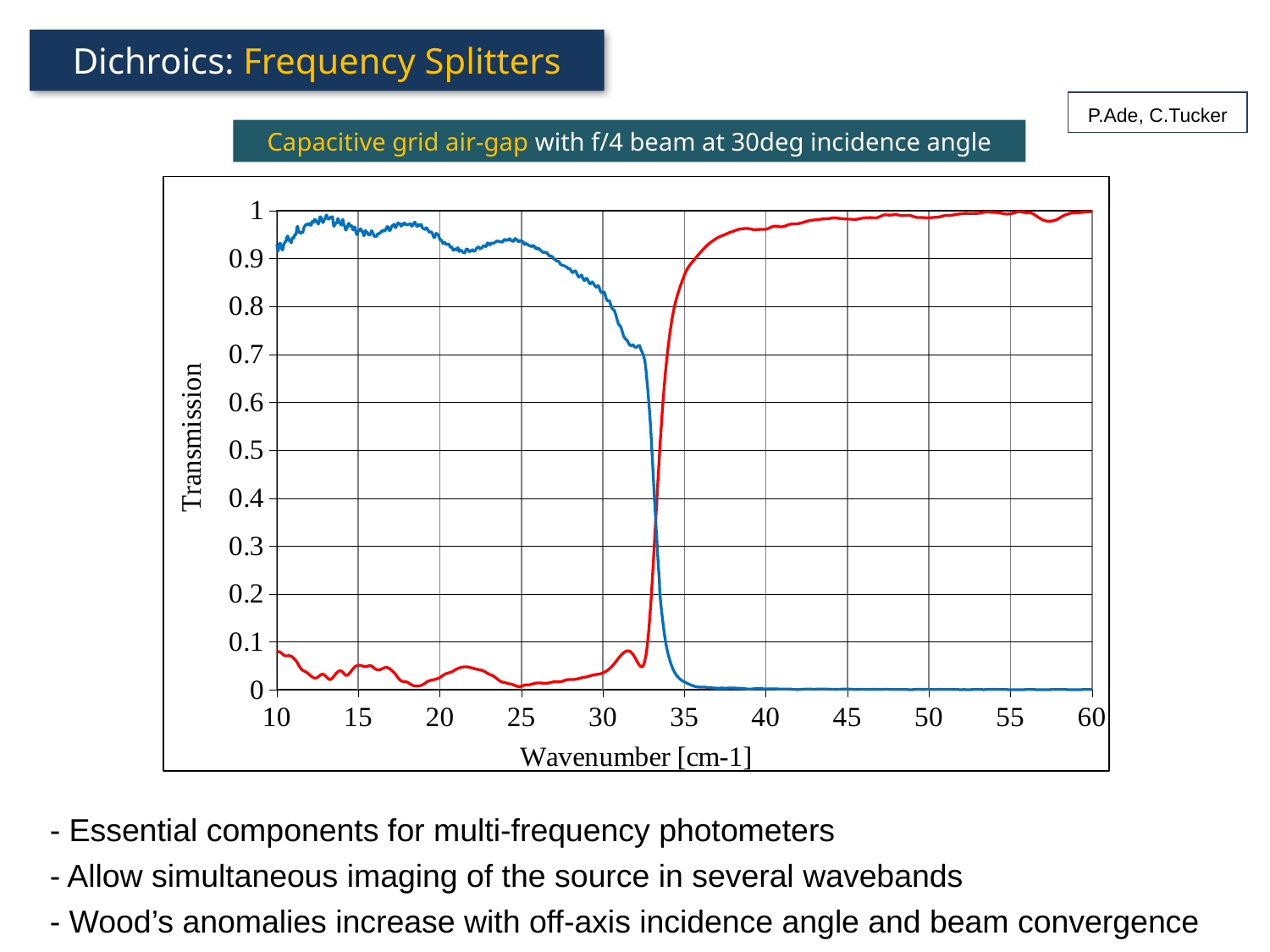
Is the transmission of the red line at wavenumber 20 greater or less than 0.1? less Does the red line rise or fall overall as wavenumber increases from 10 to 60? rise Is the transmission of the blue line at wavenumber 50 greater or less than 0.1? less Is the transmission of the red line at wavenumber 50 greater or less than 0.9? greater At wavenumber 20, which line has the higher transmission, the red line or the blue line? blue line What is the label of the y axis of the chart? Transmission What kind of chart is shown on the slide? line chart What is the label of the x axis of the chart? Wavenumber [cm-1] Does the blue line rise or fall overall as wavenumber increases from 10 to 60? fall How many lines are plotted on the chart? 2 At wavenumber 50, which line has the higher transmission, the red line or the blue line? red line